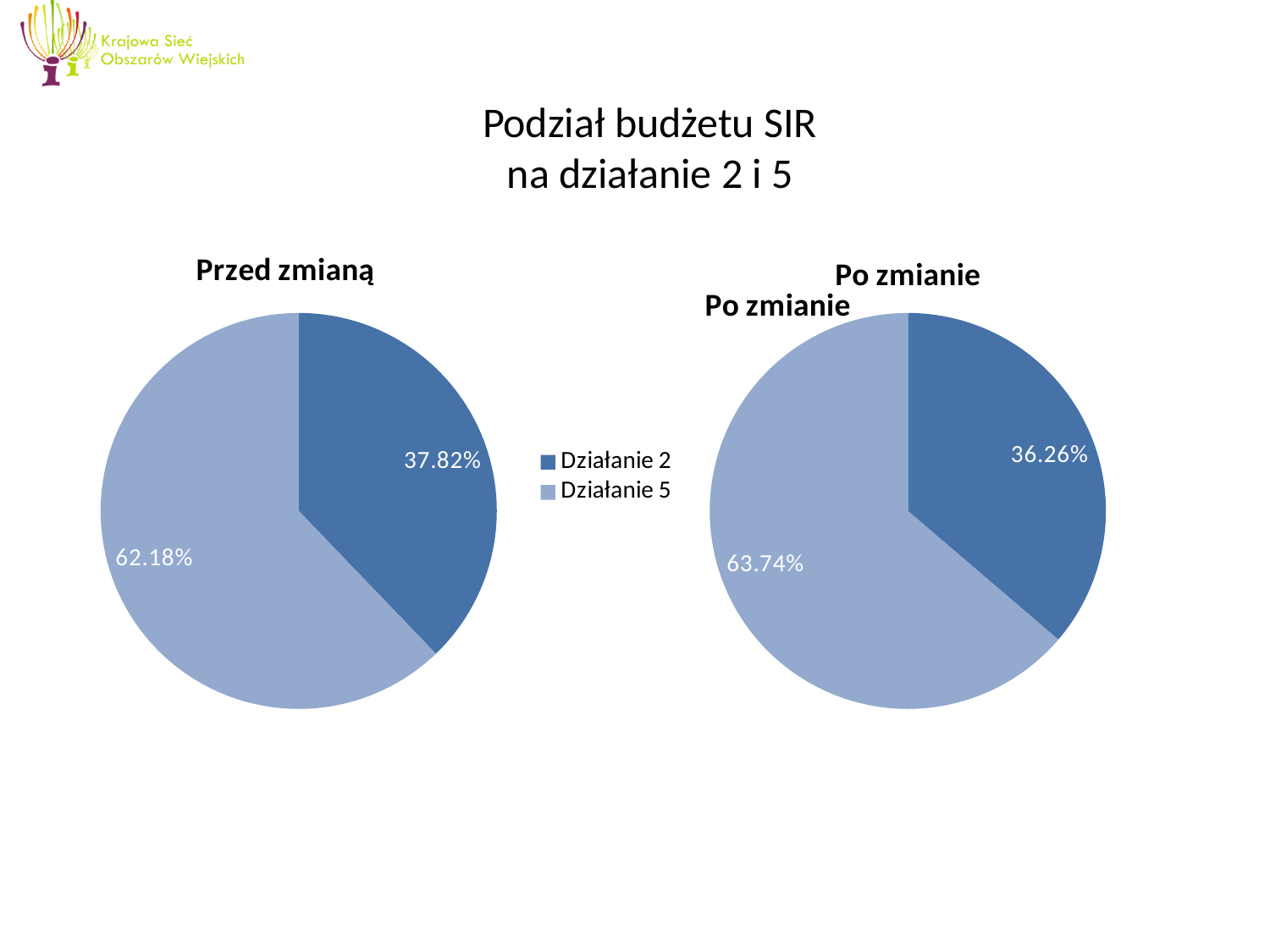
In the 'Po zmianie' chart, which category has the smallest slice? Działanie 2 What is the title of the chart on the left? Przed zmianą In the 'Przed zmianą' chart, what share does Działanie 2 have? 37.82% Is the share of Działanie 2 larger in the 'Przed zmianą' chart or in the 'Po zmianie' chart? Przed zmianą How many slices does the 'Przed zmianą' pie chart have? 2 What kind of chart is the 'Po zmianie' chart? Pie chart How many entries does the legend list? 2 In the 'Przed zmianą' chart, what share does Działanie 5 have? 62.18% In the 'Po zmianie' chart, what share does Działanie 5 have? 63.74% In the 'Przed zmianą' chart, what is the difference between the Działanie 5 and Działanie 2 shares? 24.36% In the 'Po zmianie' chart, what share does Działanie 2 have? 36.26% In the 'Przed zmianą' chart, which category has the largest slice? Działanie 5